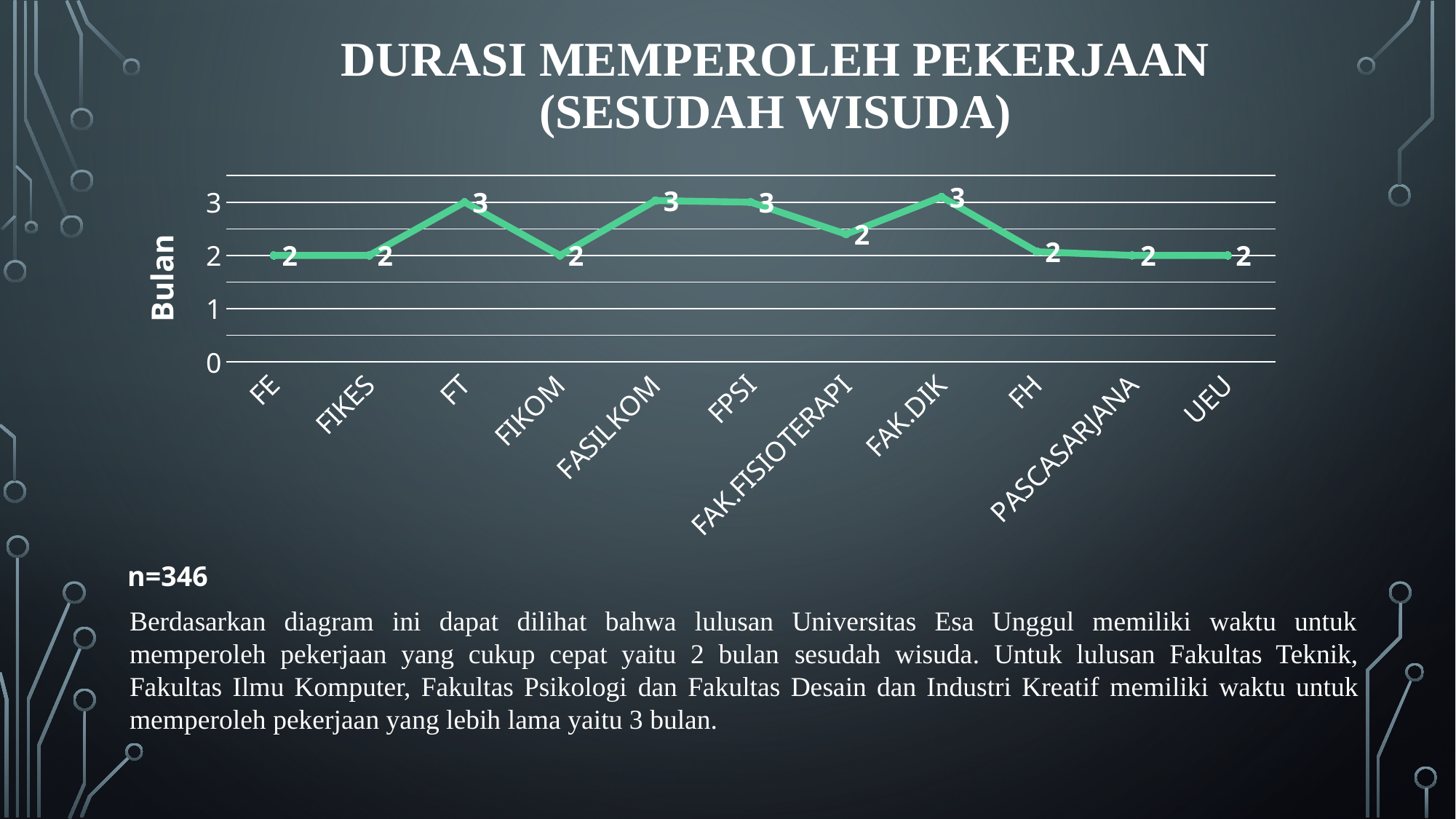
What is the value for FASILKOM? 3 Is the value for FIKES greater or less than 3? less How many categories are plotted on the x axis? 11 What is the value for UEU? 2 What is the value for FAK.DIK? 3 What is the title of the chart? DURASI MEMPEROLEH PEKERJAAN (SESUDAH WISUDA) What is the difference between the value for FPSI and the value for FH? 1 What type of chart is shown on the slide? line chart What is the label on the vertical axis? Bulan What is the value for FT? 3 What is the value for FE? 2 Which is larger, the value for FT or the value for FIKOM? FT